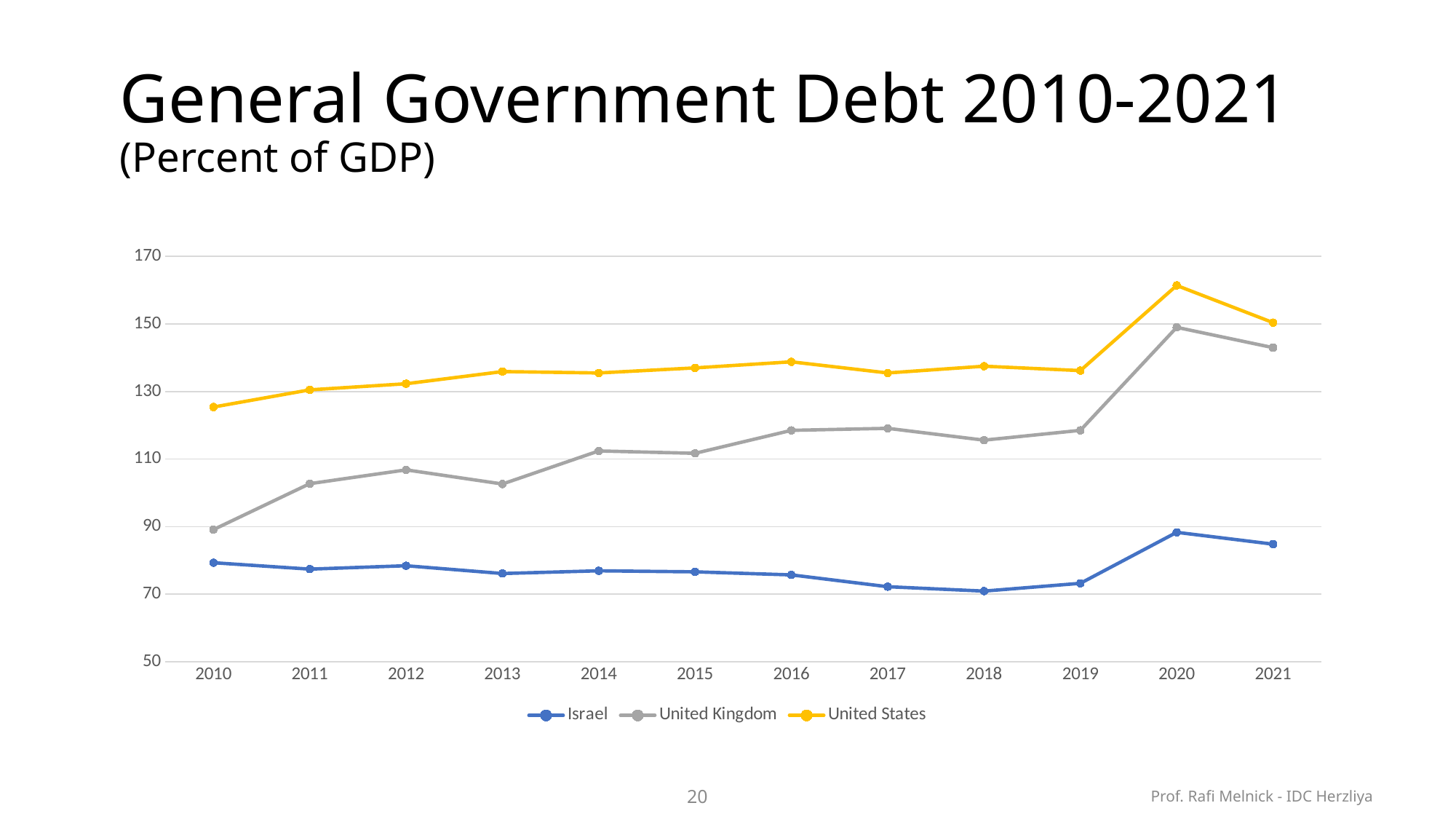
Is the value for the United States in 2010 greater or less than 130? less In which year is the United Kingdom series at its lowest value? 2010 In which year does the United States series reach its highest value? 2020 Which series has the highest value in 2021? United States How many years are plotted along the x axis? 12 In which year is the Israel series at its lowest value? 2018 Is the value for the United States in 2020 greater or less than 150? greater Does the United States series rise or fall from 2010 to 2016? rise In 2015, which is larger: the value for the United Kingdom or the value for Israel? United Kingdom What is the subtitle shown under the chart title on the slide? (Percent of GDP) How many series does the legend list? 3 What kind of chart is shown on the slide? line chart